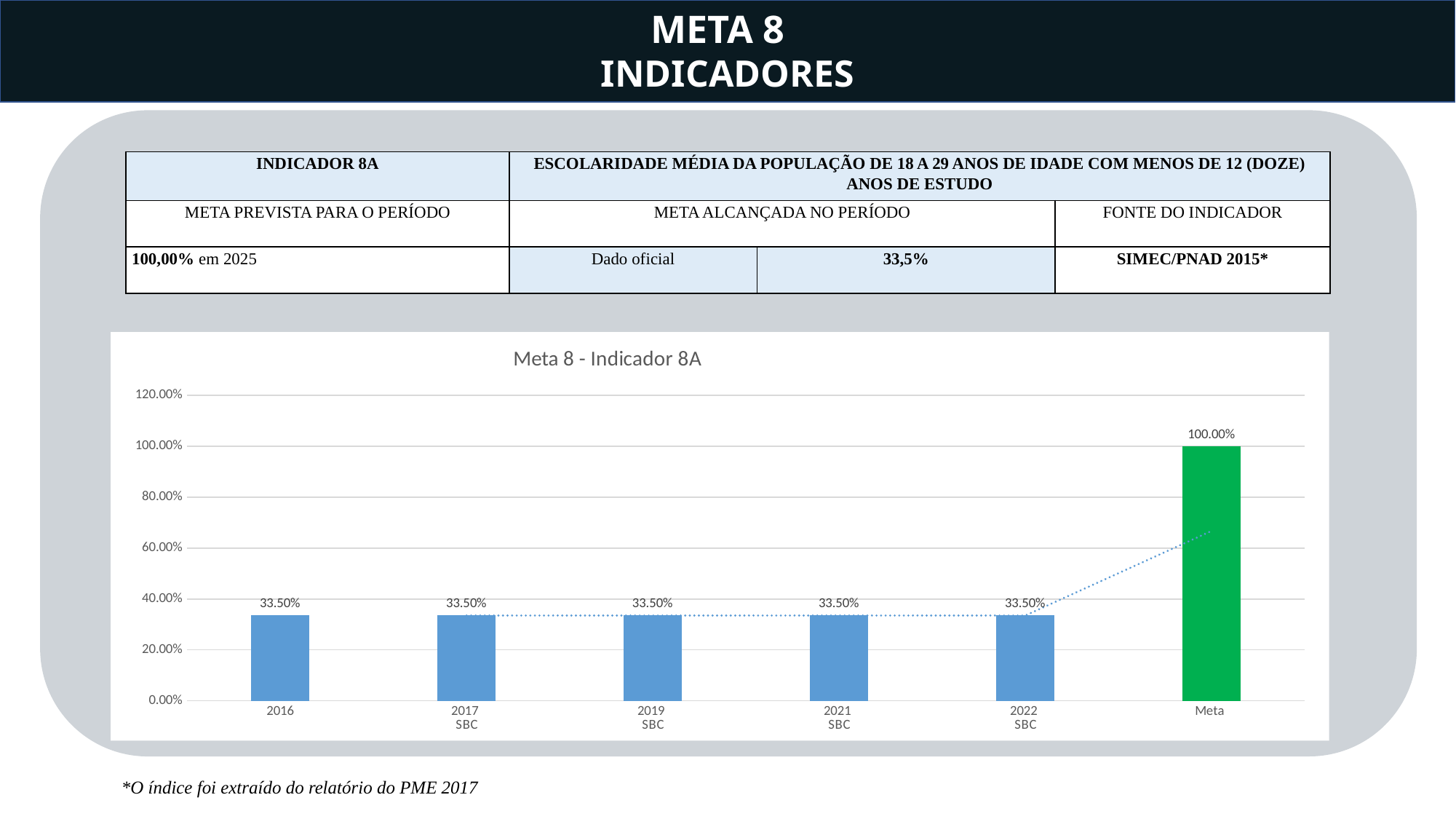
How many categories are shown on the x axis of the chart? 6 What is the value for 2022 SBC in the chart? 33.50% What is the value for Meta in the chart? 100.00% Do the values change from 2016 to 2022 SBC in the chart? No, they stay at 33.50% What is the value for 2016 in the chart? 33.50% What is the difference between the Meta value and the 2021 SBC value? 66.50% Is the value for Meta greater or less than 80.00%? greater Which category has the highest value in the chart? Meta What is the title of the chart? Meta 8 - Indicador 8A What kind of chart is shown on the slide? bar chart Is the value for 2017 SBC greater or less than 40.00%? less Which is larger, the value for Meta or the value for 2019 SBC? Meta